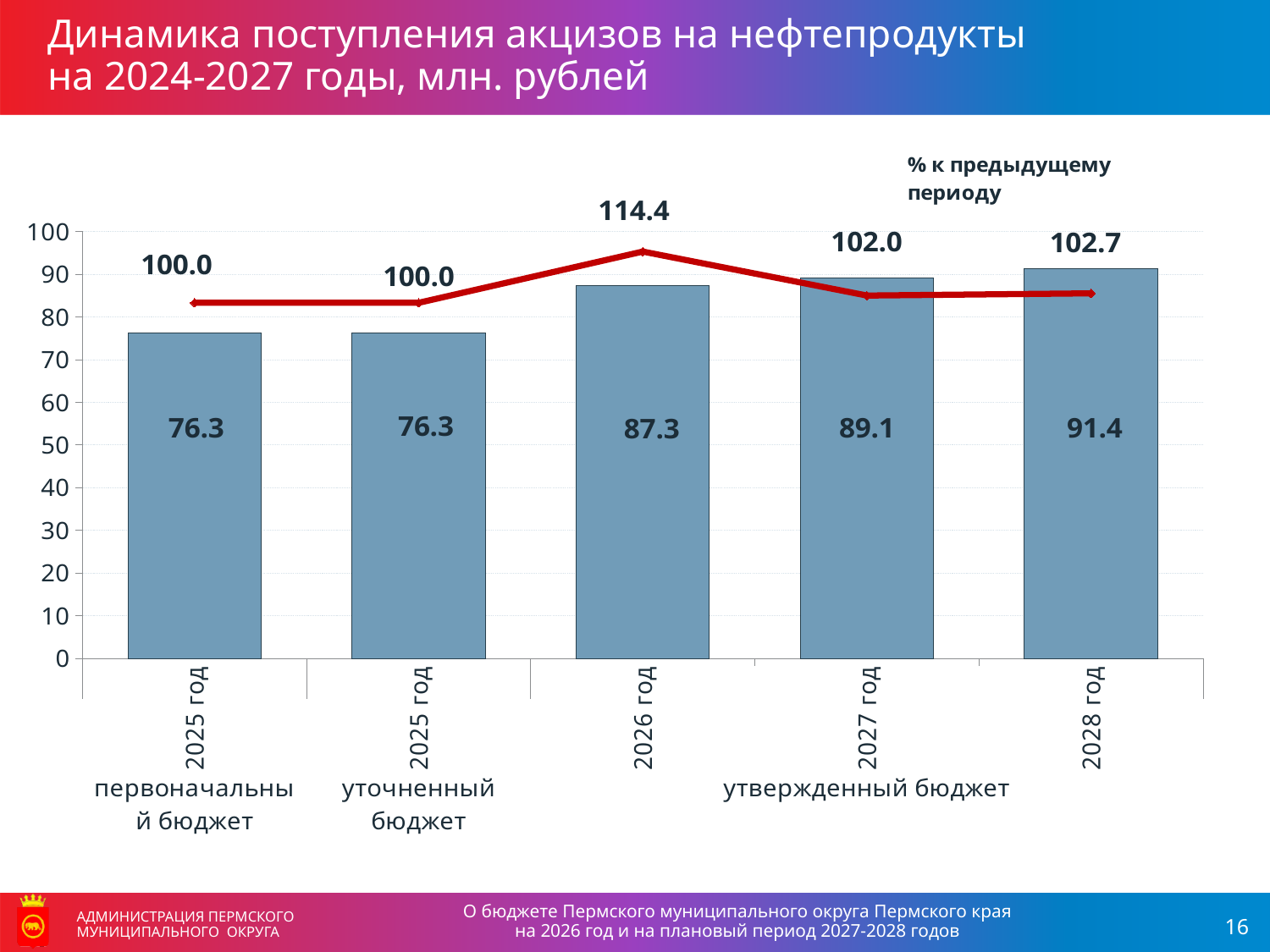
What is the difference between the bar values for 2026 год and 2025 год (уточненный бюджет)? 11.0 What is the value of the bar for 2028 год? 91.4 Do the bar values rise or fall from 2026 год to 2028 год? rise How many bars are plotted on the chart? 5 Which year has the highest bar value? 2028 год What is the '% к предыдущему периоду' value shown for 2026 год? 114.4 What is the '% к предыдущему периоду' value shown for 2027 год? 102.0 What is the difference between the bar values for 2028 год and 2027 год? 2.3 Which is larger: the bar value for 2027 год or for 2026 год? 2027 год What is the value of the bar for 2025 год in the уточненный бюджет group? 76.3 What is the value of the bar for 2026 год (утвержденный бюджет)? 87.3 Which year has the highest '% к предыдущему периоду' value? 2026 год